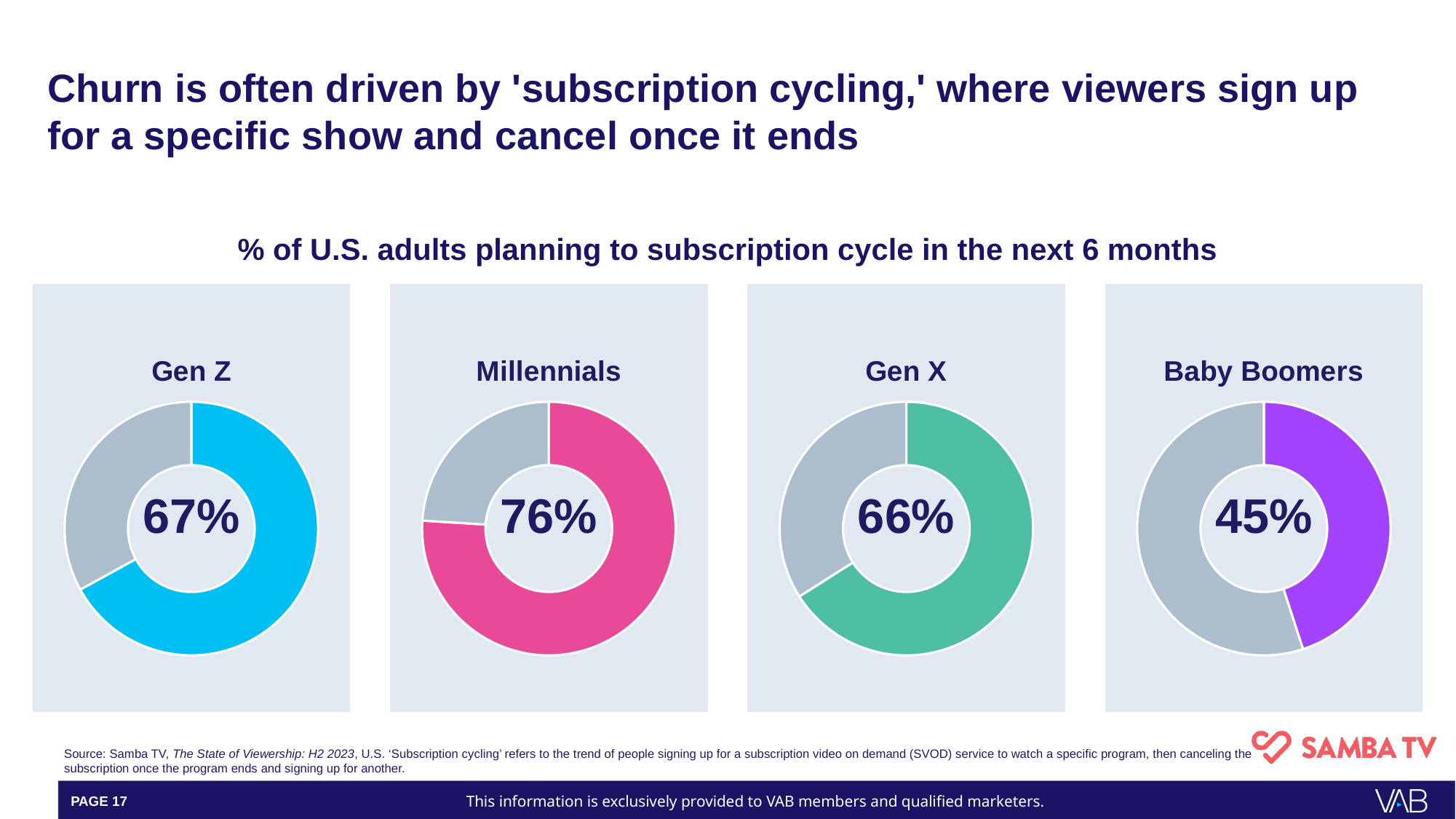
In the Millennials donut chart, what value is shown in the centre? 76% In the Baby Boomers donut chart, what percentage of U.S. adults plan to subscription cycle in the next 6 months? 45% How many donut charts are shown on the slide? 4 What kind of chart is used to show the Gen Z value? Donut chart Comparing the Millennials and Baby Boomers donut charts, how many percentage points higher is the Millennials value? 31 What is the shared title above the four donut charts? % of U.S. adults planning to subscription cycle in the next 6 months In the Gen Z donut chart, what percentage of U.S. adults plan to subscription cycle in the next 6 months? 67% Across the four donut charts, which generation has the lowest share planning to subscription cycle? Baby Boomers In the Gen X donut chart, what percentage is shown? 66% Comparing the Gen Z and Baby Boomers donut charts, what is the difference between their values in percentage points? 22 Comparing the Millennials and Gen X donut charts, which shows the larger value? Millennials Across the four donut charts, which generation has the highest share planning to subscription cycle? Millennials